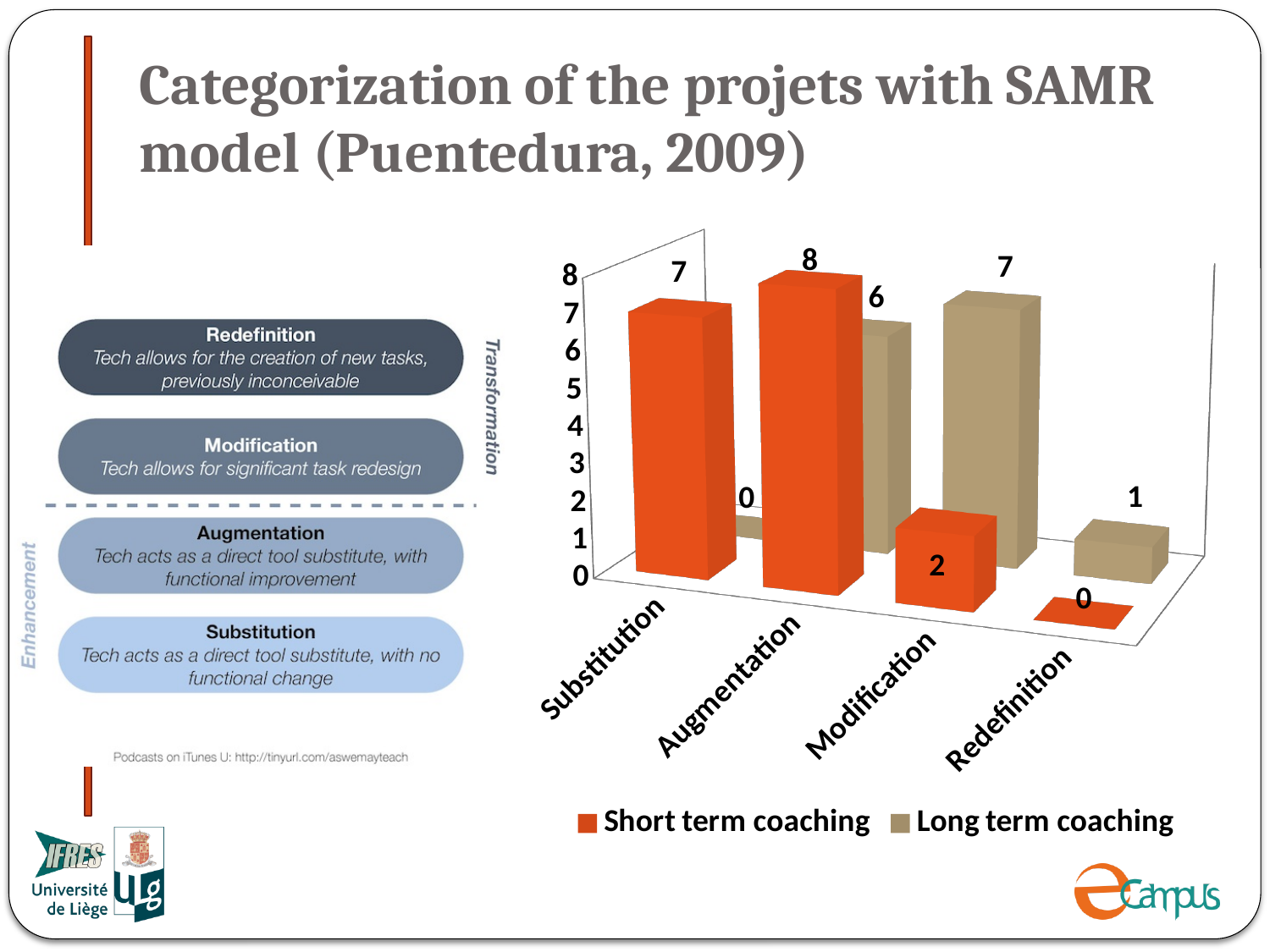
What is the value for Short term coaching in the Redefinition category? 0 Which category has the highest value for Short term coaching? Augmentation What is the value for Long term coaching in the Modification category? 7 Which colour represents Long term coaching in the chart? Tan (beige) What kind of chart is shown on the slide? Bar chart What is the value for Short term coaching in the Substitution category? 7 Which category has the lowest value for Long term coaching? Substitution What is the difference between Short term coaching and Long term coaching in the Augmentation category? 2 How many categories are shown on the x axis of the chart? 4 In the Modification category, which series has the larger value, Short term coaching or Long term coaching? Long term coaching What is the value for Long term coaching in the Substitution category? 0 How many series does the chart legend list? 2